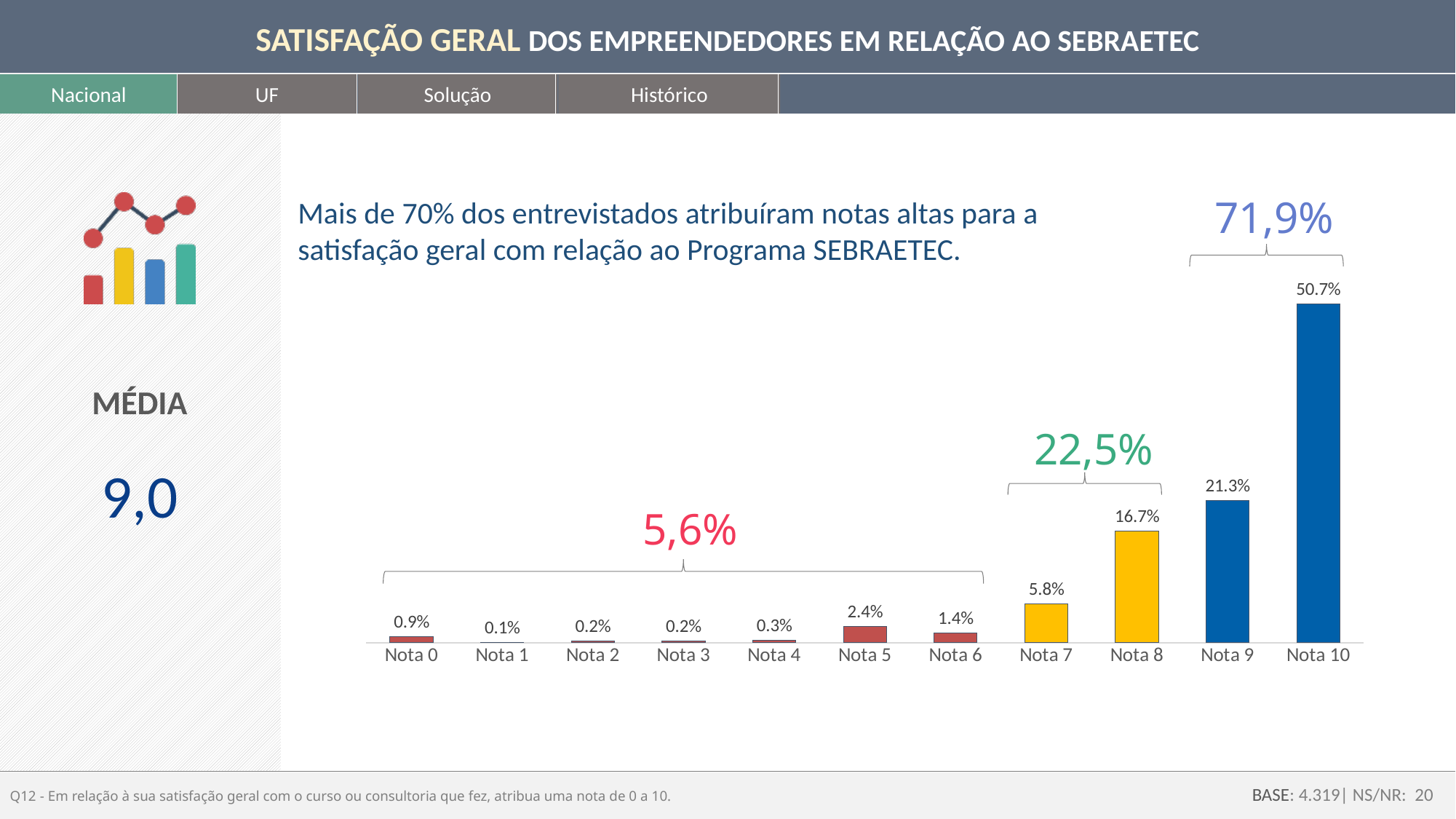
What is the value for Nota 10? 50.7% Do the values generally rise or fall from Nota 7 to Nota 10? rise What is the value for Nota 8? 16.7% What combined percentage is shown above the bracket covering Nota 7 and Nota 8? 22,5% Which category has the highest value? Nota 10 Which category has the lowest value? Nota 1 Which is larger, the value for Nota 7 or the value for Nota 6? Nota 7 What is the MÉDIA (average) value shown on the left of the slide? 9,0 What kind of chart is shown on the slide? bar chart What is the value for Nota 5? 2.4% What is the difference between the values for Nota 10 and Nota 9? 29.4% How many categories are shown on the x axis? 11